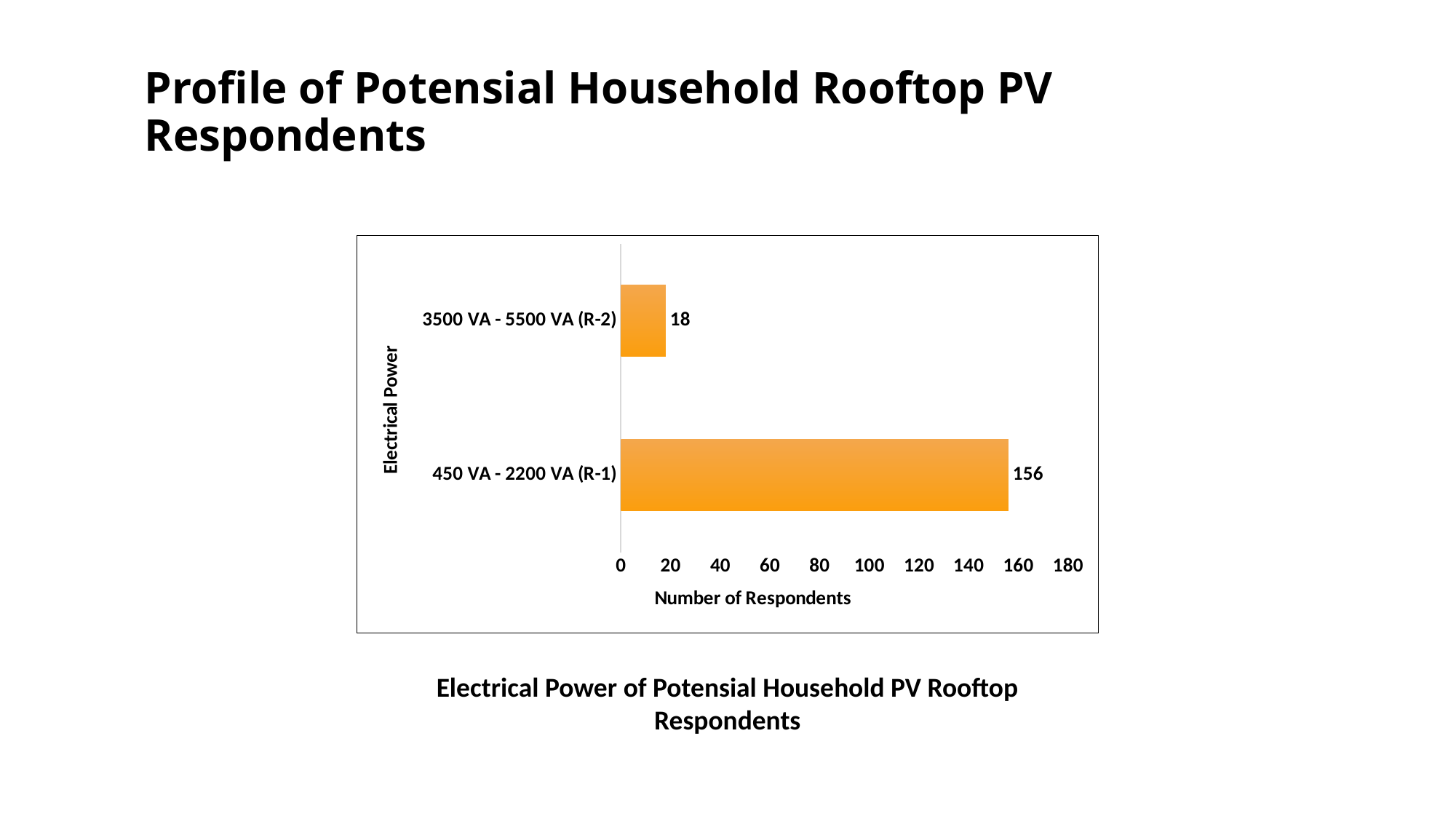
Which electrical power category has the highest number of respondents? 450 VA - 2200 VA (R-1) What is the difference in the number of respondents between 450 VA - 2200 VA (R-1) and 3500 VA - 5500 VA (R-2)? 138 How many electrical power categories are shown in the chart? 2 Which has more respondents, 450 VA - 2200 VA (R-1) or 3500 VA - 5500 VA (R-2)? 450 VA - 2200 VA (R-1) Is the number of respondents for 450 VA - 2200 VA (R-1) greater or less than 140? greater Is the number of respondents for 3500 VA - 5500 VA (R-2) greater or less than 20? less What is the label of the horizontal axis of the chart? Number of Respondents How many respondents are in the 450 VA - 2200 VA (R-1) category? 156 Which electrical power category has the lowest number of respondents? 3500 VA - 5500 VA (R-2) What is the label of the vertical axis of the chart? Electrical Power What type of chart is shown on the slide? Bar chart How many respondents are in the 3500 VA - 5500 VA (R-2) category? 18